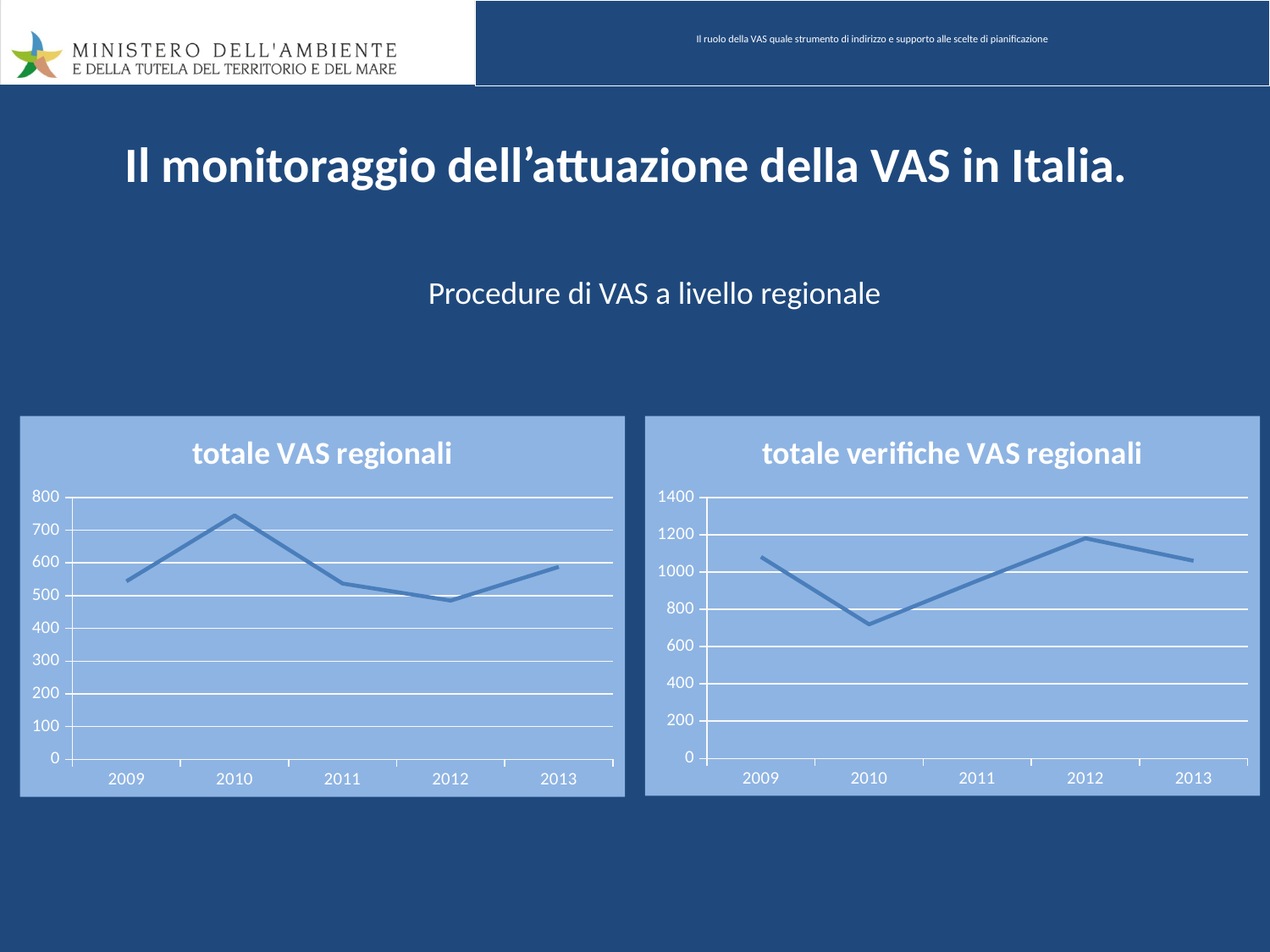
In the 'totale VAS regionali' chart, which year has the highest value? 2010 In the 'totale VAS regionali' chart, is the value for 2010 greater or less than 700? greater In the 'totale verifiche VAS regionali' chart, which year has the lowest value? 2010 In the 'totale verifiche VAS regionali' chart, which year has the highest value? 2012 In the 'totale VAS regionali' chart, which year has the lowest value? 2012 In the 'totale verifiche VAS regionali' chart, do the values rise or fall from 2010 to 2012? rise In the 'totale verifiche VAS regionali' chart, which is larger, the value for 2009 or the value for 2010? 2009 What kind of chart is the 'totale VAS regionali' chart? line chart How many years are plotted on the x axis of the 'totale VAS regionali' chart? 5 What is the title of the chart on the right side of the slide? totale verifiche VAS regionali In the 'totale verifiche VAS regionali' chart, is the value for 2010 greater or less than 800? less